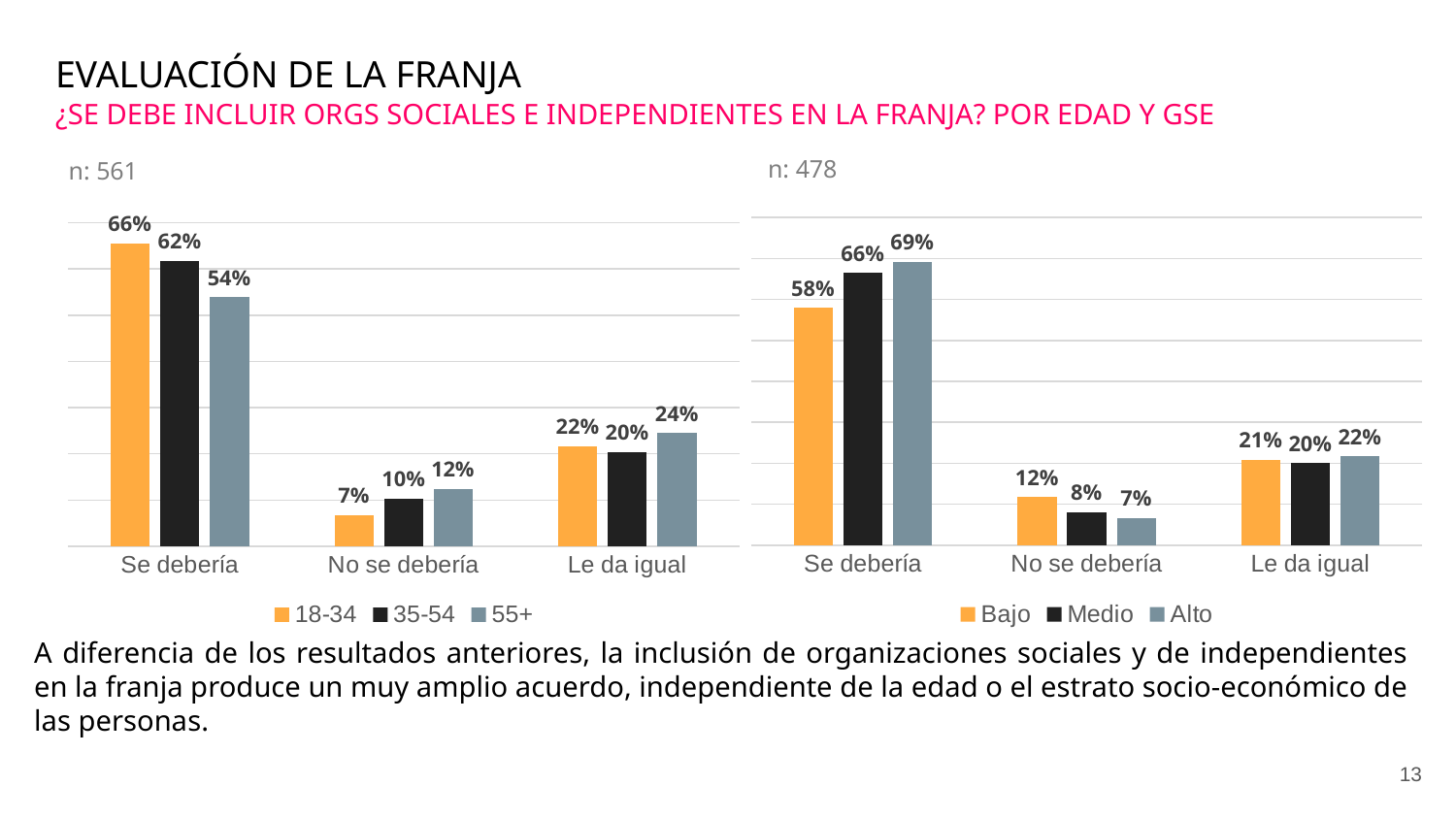
In the left chart (n: 561, by age), what is the difference between the 18-34 and 55+ values in the 'Se debería' category? 12% What kind of chart is the left chart (n: 561, by age)? Bar chart What are the legend entries of the right chart (n: 478, by GSE)? Bajo, Medio, Alto In the right chart (n: 478, by GSE), what is the value for Alto in the 'Se debería' category? 69% In the right chart (n: 478, by GSE), which series has the lowest value in the 'No se debería' category? Alto How many categories are shown on the x axis of the left chart (n: 561, by age)? 3 In the left chart (n: 561, by age), what is the value for 18-34 in the 'Se debería' category? 66% In the right chart (n: 478, by GSE), what is the difference between the Bajo and Medio values in the 'Se debería' category? 8% In the right chart (n: 478, by GSE), which is larger in the 'No se debería' category: Bajo or Medio? Bajo How many series does the legend of the right chart (n: 478, by GSE) list? 3 In the left chart (n: 561, by age), what is the value for 55+ in the 'No se debería' category? 12% In the left chart (n: 561, by age), which series has the highest value in the 'Le da igual' category? 55+